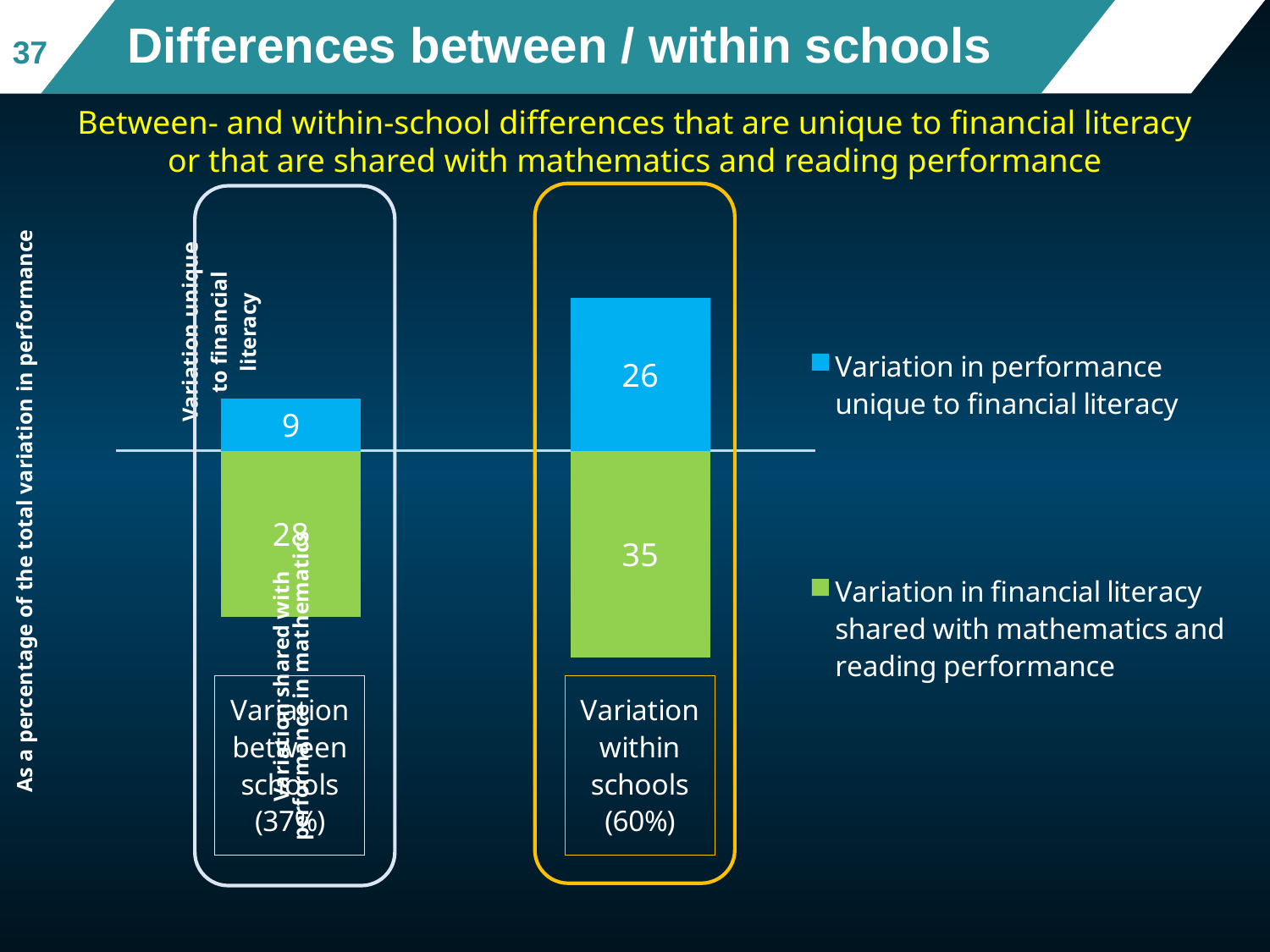
Which bar has the larger value for variation unique to financial literacy, 'Variation between schools' or 'Variation within schools'? Variation within schools In the 'Variation within schools' bar, what is the difference between the shared variation (35) and the unique variation (26)? 9 How many series does the legend list? 2 What is the value of variation in performance unique to financial literacy for the 'Variation within schools' bar? 26 What is the difference between the variation unique to financial literacy within schools (26) and between schools (9)? 17 What is the value of variation in financial literacy shared with mathematics and reading performance for the 'Variation within schools' bar? 35 How many bars (categories) are shown in the chart? 2 What percentage is printed in the label for 'Variation within schools'? 60% What colour represents 'Variation in performance unique to financial literacy' in the legend? blue What kind of chart is shown on the slide? bar chart What is the value of variation in performance unique to financial literacy for the 'Variation between schools' bar? 9 Which bar has the larger value for variation shared with mathematics and reading performance? Variation within schools